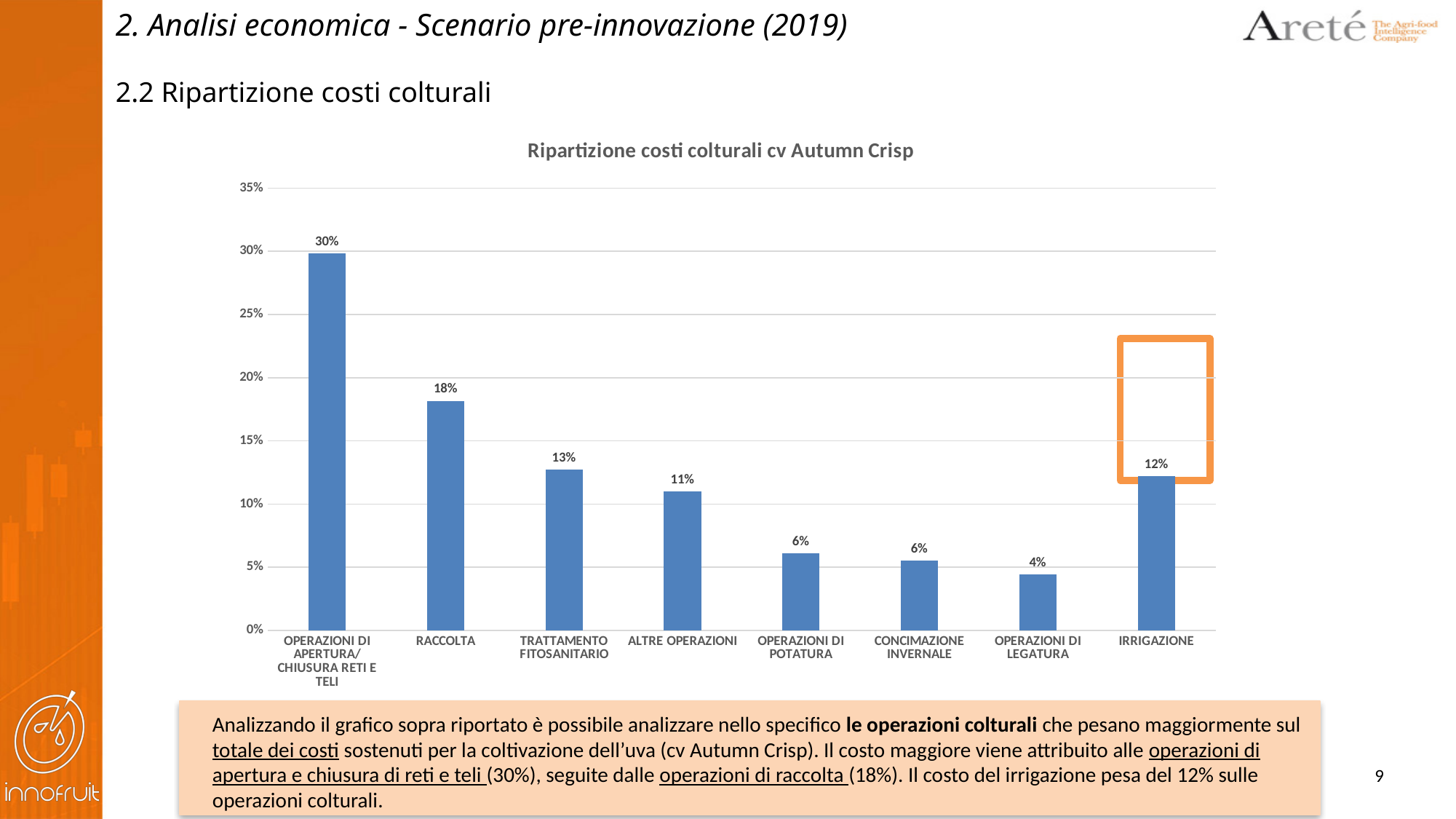
Which category's bar is highlighted with an orange rectangle? IRRIGAZIONE How many categories are shown on the x axis? 8 What is the value for RACCOLTA? 18% What is the value for TRATTAMENTO FITOSANITARIO? 13% What is the title of the chart? Ripartizione costi colturali cv Autumn Crisp Which is larger, the value for ALTRE OPERAZIONI or the value for IRRIGAZIONE? IRRIGAZIONE What kind of chart is shown on the slide? bar chart What is the difference between the values for OPERAZIONI DI APERTURA/CHIUSURA RETI E TELI and RACCOLTA? 12% Is the value for OPERAZIONI DI POTATURA greater or less than 10%? less What is the value for IRRIGAZIONE? 12% Which category has the lowest value? OPERAZIONI DI LEGATURA Which category has the highest value? OPERAZIONI DI APERTURA/CHIUSURA RETI E TELI